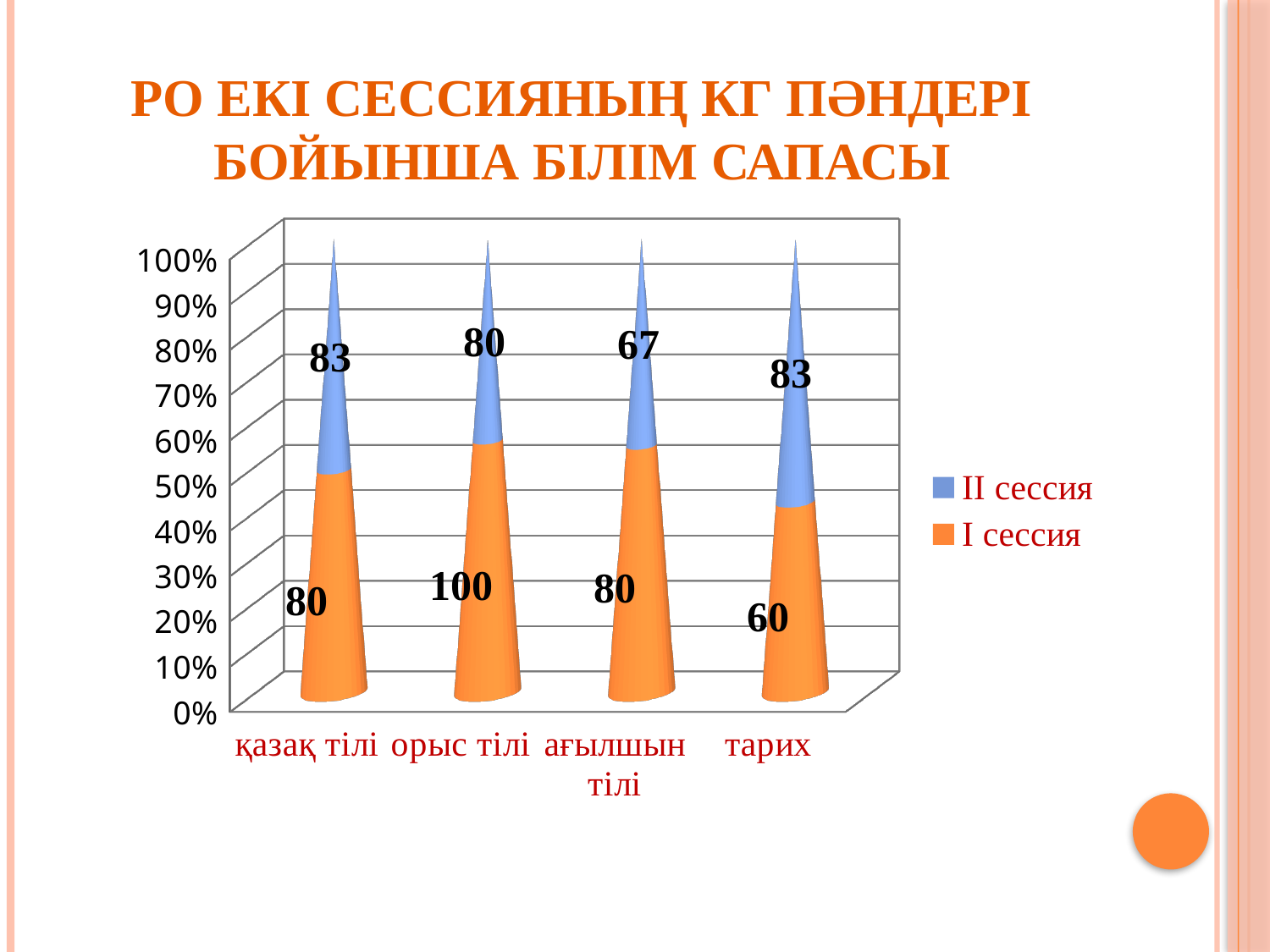
What is the difference between the I сессия and II сессия values for тарих? 23 Which subject has the highest I сессия value? орыс тілі What is the II сессия value for қазақ тілі? 83 What kind of chart is shown on the slide? bar chart How many series does the legend list? 2 What is the I сессия value for тарих? 60 How many subjects are shown on the x axis? 4 Which subject has the lowest II сессия value? ағылшын тілі Which subject has the lowest I сессия value? тарих What is the I сессия value for орыс тілі? 100 Which is larger for орыс тілі: the I сессия value or the II сессия value? I сессия What is the II сессия value for ағылшын тілі? 67